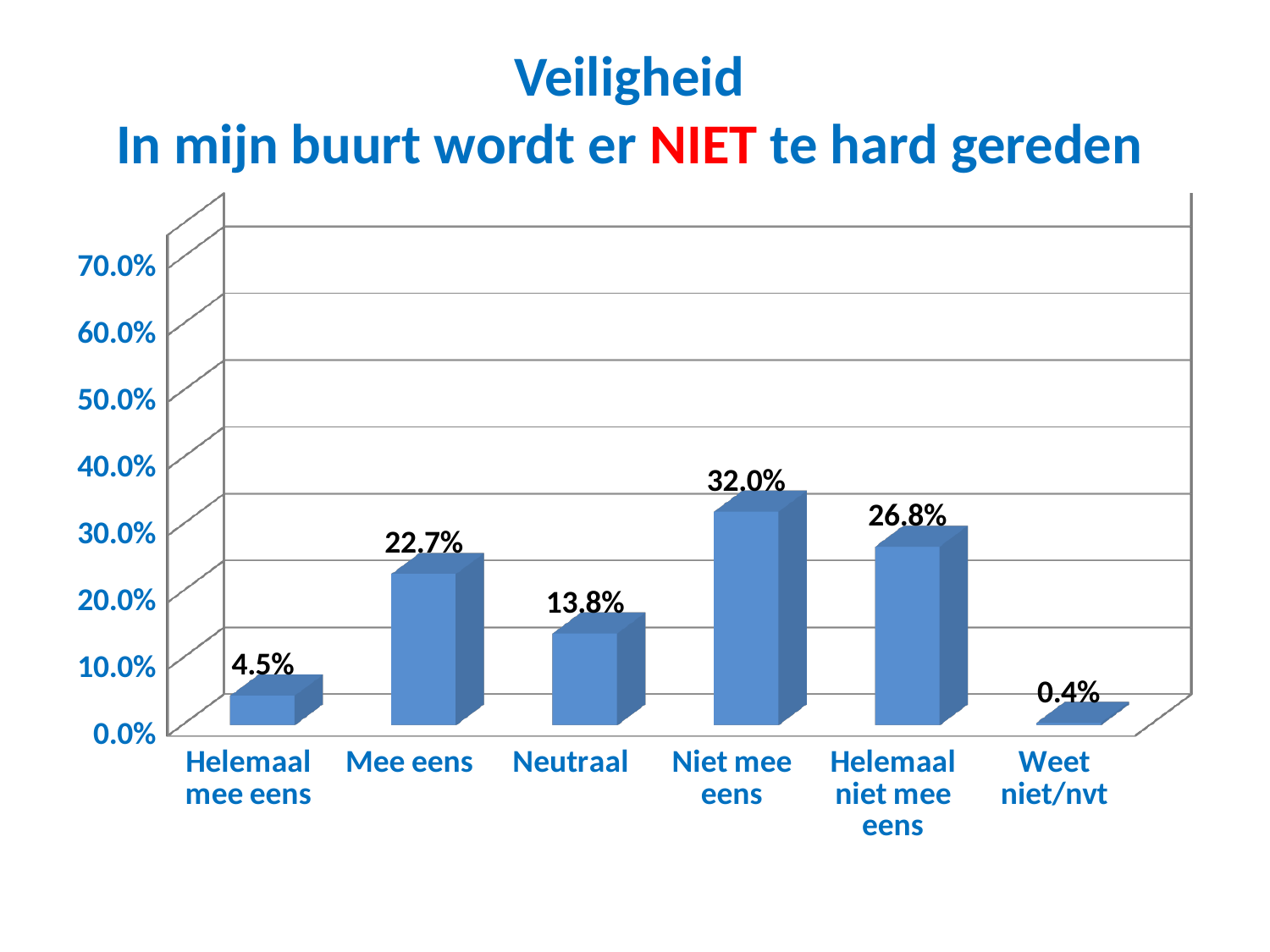
What kind of chart is shown on the slide? bar chart What is the difference between the values for "Niet mee eens" and "Helemaal niet mee eens"? 5.2% What is the difference between the values for "Mee eens" and "Neutraal"? 8.9% What is the value for "Niet mee eens"? 32.0% What is the title of the chart? Veiligheid In mijn buurt wordt er NIET te hard gereden Which category has the lowest value? Weet niet/nvt How many categories are shown on the x axis? 6 Which is larger, the value for "Mee eens" or the value for "Helemaal niet mee eens"? Helemaal niet mee eens What is the value for "Neutraal"? 13.8% What is the value for "Helemaal mee eens"? 4.5% Is the value for "Niet mee eens" greater or less than 30.0%? greater Which category has the highest value? Niet mee eens